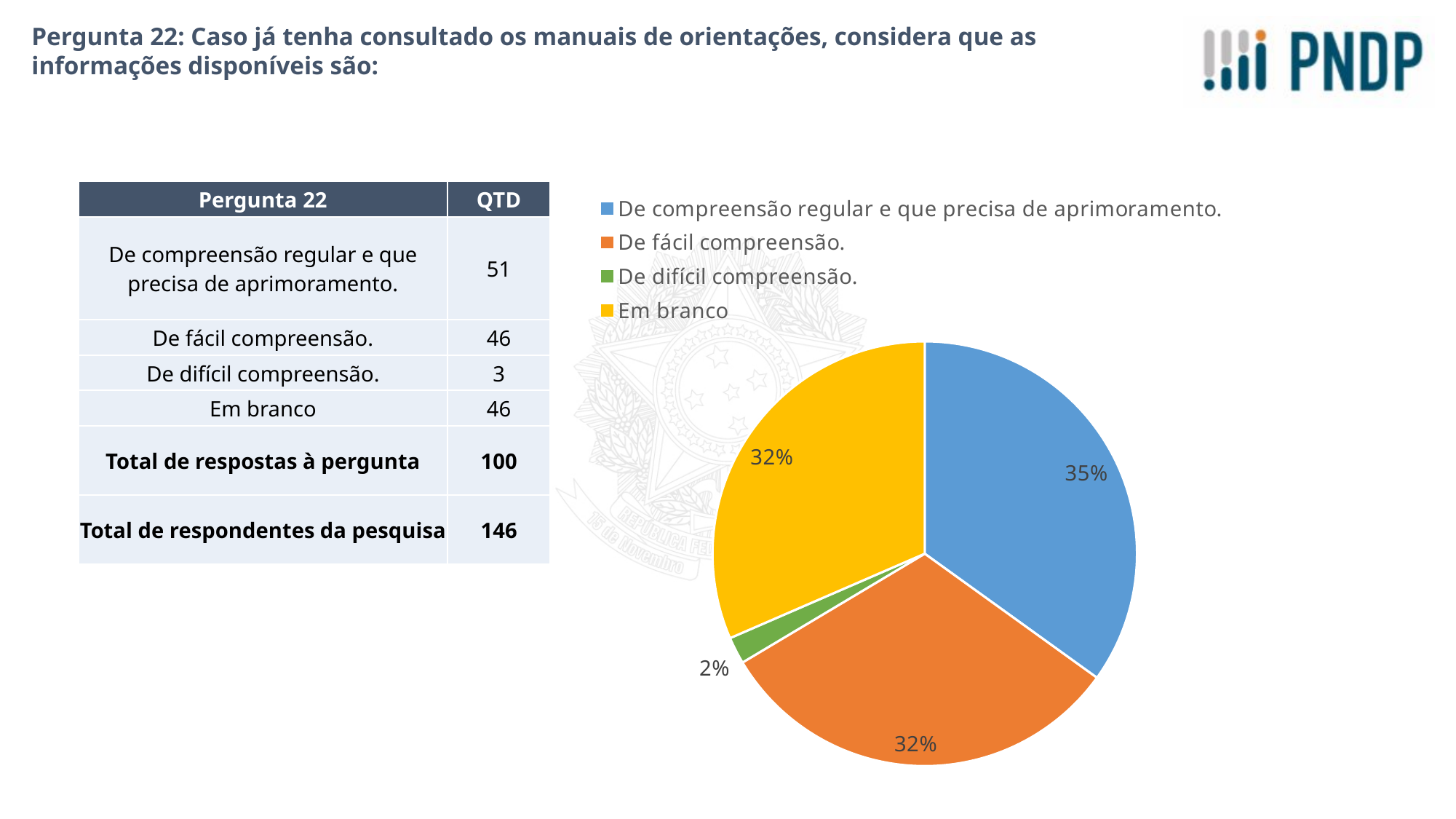
What share of the pie does "De fácil compreensão." have? 32% What share of the pie does "De compreensão regular e que precisa de aprimoramento." have? 35% What is the difference in percentage points between the "De compreensão regular e que precisa de aprimoramento." slice and the "De difícil compreensão." slice? 33% What share of the pie does "De difícil compreensão." have? 2% How many entries does the legend list? 4 Which category has the smallest slice of the pie? De difícil compreensão. What colour is the "Em branco" slice in the pie chart? yellow Which category has the largest slice of the pie? De compreensão regular e que precisa de aprimoramento. What kind of chart is shown on the slide? pie chart How many slices does the pie chart have? 4 Which slice is larger: "De compreensão regular e que precisa de aprimoramento." or "De fácil compreensão."? De compreensão regular e que precisa de aprimoramento.